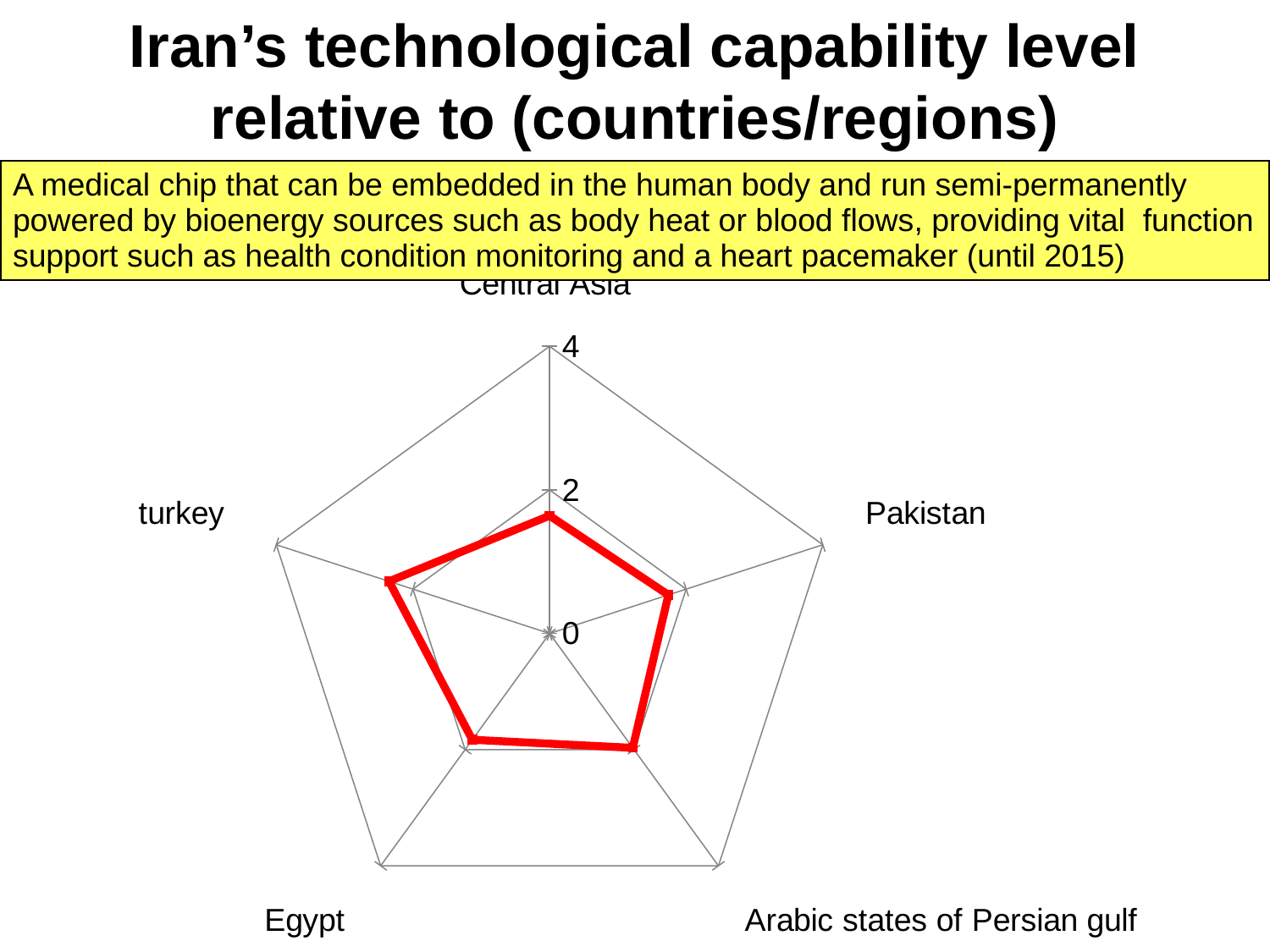
What is the title of the slide containing the chart? Iran's technological capability level relative to (countries/regions) How many countries/regions are plotted on the radar chart? 5 What kind of chart is shown on the slide? radar chart Is the value for turkey greater or less than 4? less Which category label appears at the top of the radar chart? Central Asia Which is larger, the value for turkey or the value for Central Asia? turkey What is the highest value shown on the chart's axis scale? 4 Is the value for Egypt greater or less than 4? less Is the value for Pakistan greater or less than 4? less